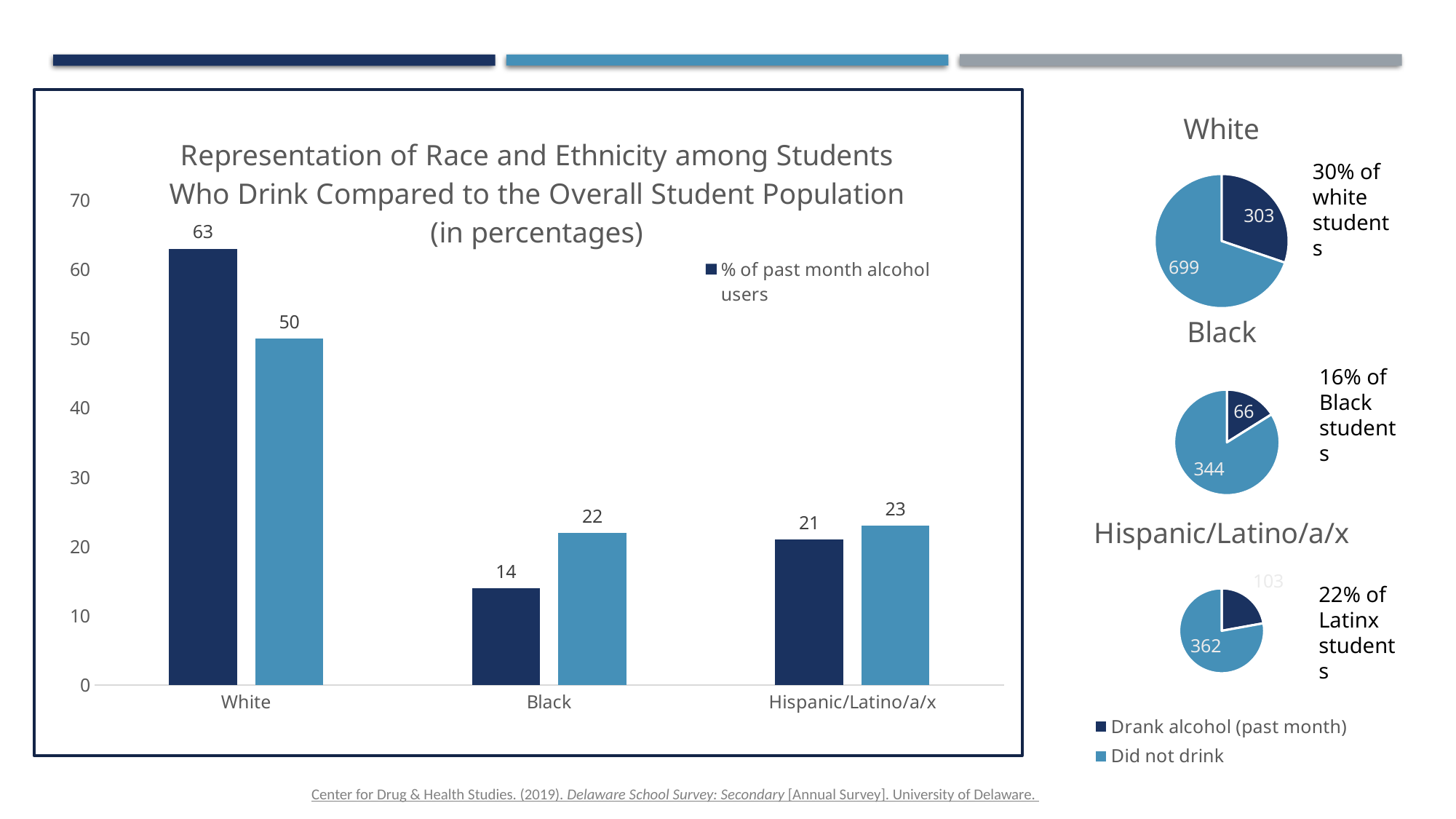
In the bar chart, how many categories are shown on the x axis? 3 How many entries does the legend below the pie charts list? 2 In the bar chart, what is the % of past month alcohol users for Black students? 14 In the White pie chart, how many students drank alcohol in the past month? 303 In the bar chart, what is the % of past month alcohol users for Hispanic/Latino/a/x students? 21 In the bar chart, what is the % of past month alcohol users for White students? 63 In the Black pie chart, how many students did not drink? 344 What kind of chart is the large chart on the left of the slide? bar chart In the bar chart, which category has the highest % of past month alcohol users? White In the bar chart, what is the difference between the % of past month alcohol users for White and for Black students? 49 In the Black pie chart, what is the total number of students across both slices? 410 In the bar chart, which category has the lowest % of past month alcohol users? Black